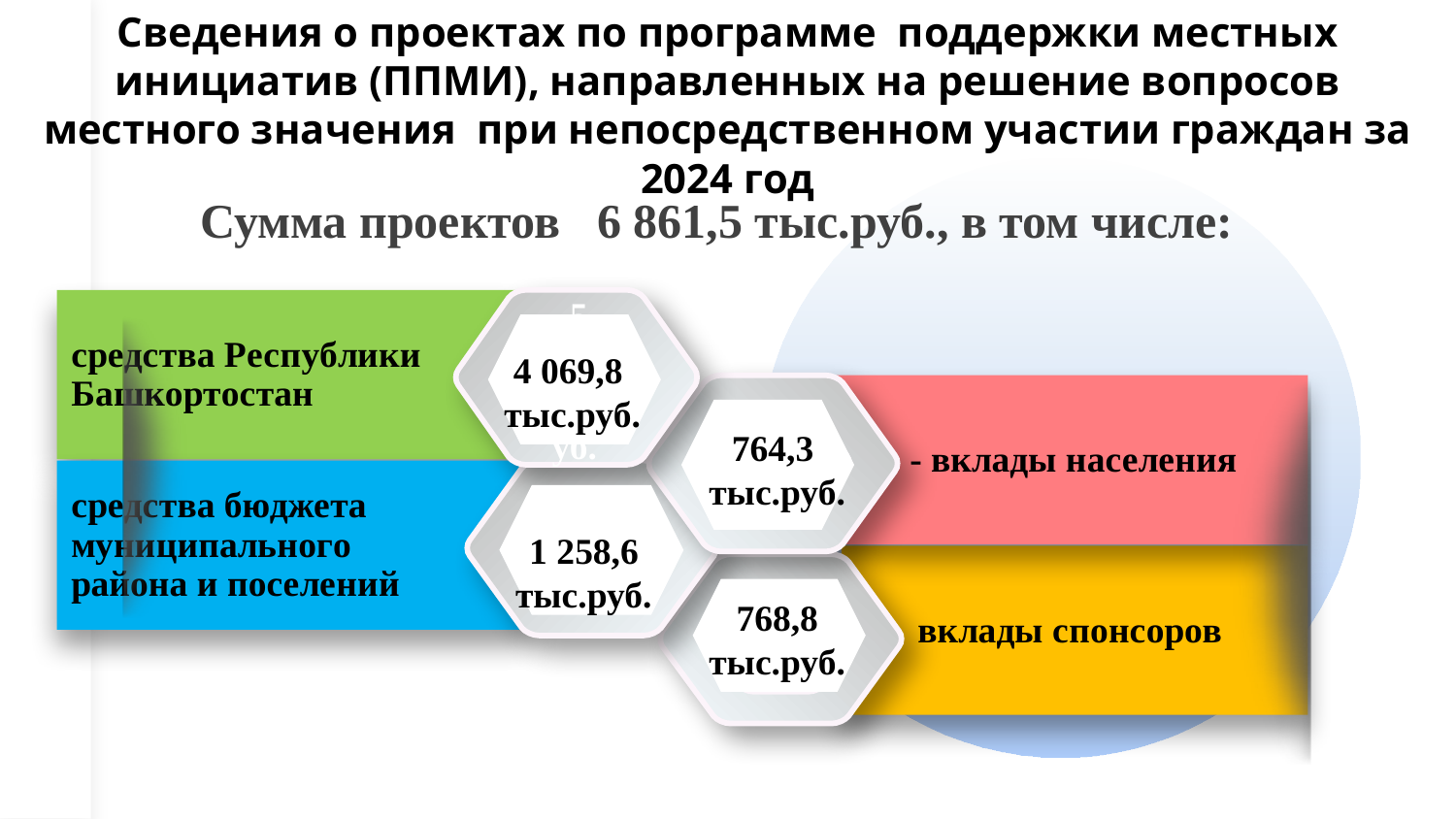
Which funding source has the largest value? средства Республики Башкортостан What is the value shown for вклады спонсоров? 768,8 тыс.руб. What is the difference between средства Республики Башкортостан and средства бюджета муниципального района и поселений? 2 811,2 тыс.руб. What is the value shown for средства Республики Башкортостан? 4 069,8 тыс.руб. What is the total sum of projects stated on the slide? 6 861,5 тыс.руб. What is the difference between вклады спонсоров and вклады населения? 4,5 тыс.руб. What colour is the block for вклады спонсоров? Yellow Which funding source has the smallest value? вклады населения What is the value shown for вклады населения? 764,3 тыс.руб. Which is larger, вклады спонсоров or вклады населения? вклады спонсоров How many funding sources are shown on the slide? 4 What is the value shown for средства бюджета муниципального района и поселений? 1 258,6 тыс.руб.